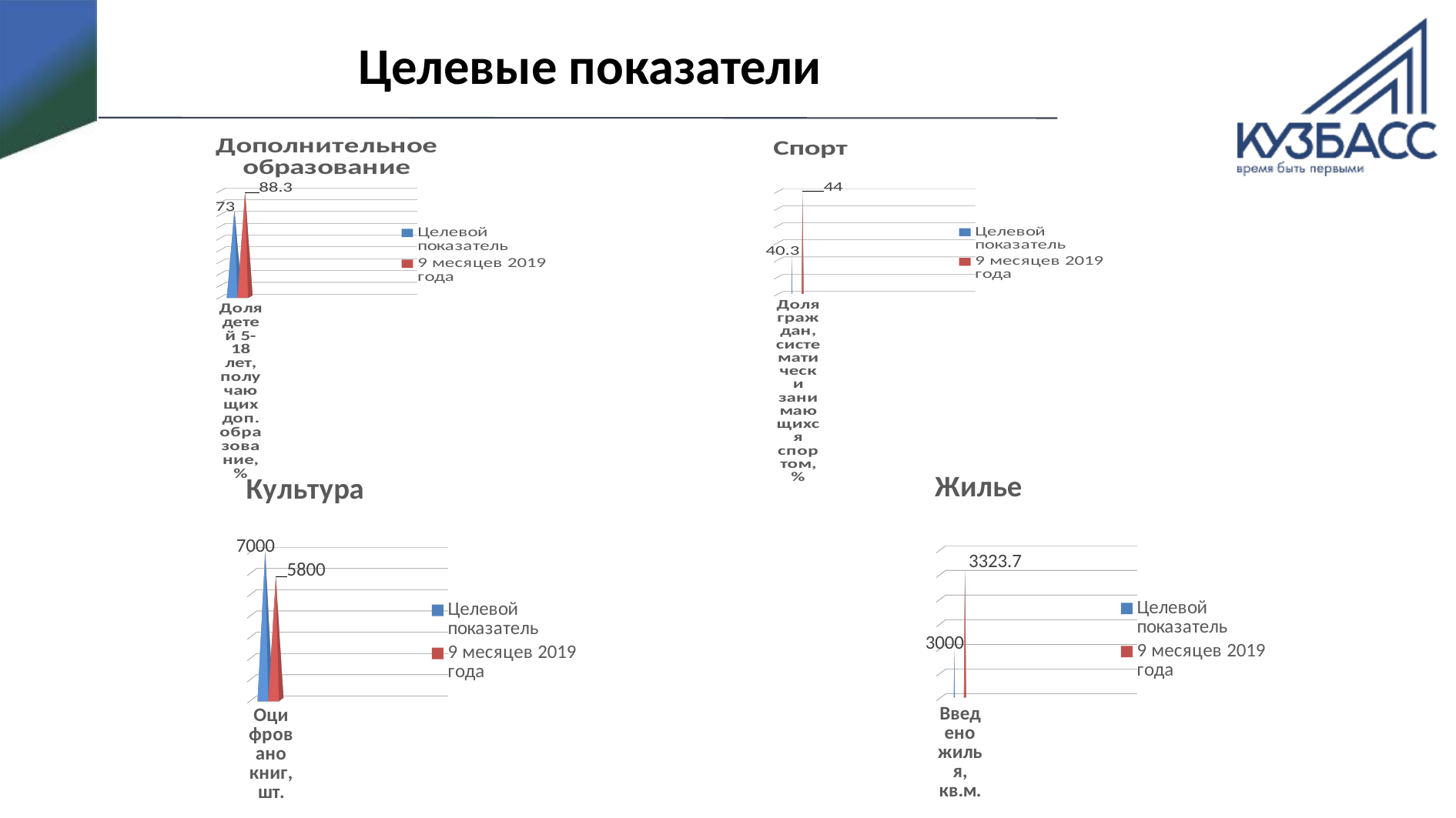
In the 'Спорт' chart, what is the value for 'Целевой показатель'? 40.3 What kind of chart is the 'Жилье' chart? Bar chart In the 'Дополнительное образование' chart, what is the value for 'Целевой показатель'? 73 In the 'Спорт' chart, what is the value for '9 месяцев 2019 года'? 44 In the 'Жилье' chart, what is the value for '9 месяцев 2019 года'? 3323.7 How many series does the legend of the 'Спорт' chart list? 2 In the 'Дополнительное образование' chart, what is the value for '9 месяцев 2019 года'? 88.3 In the 'Культура' chart, what is the value for 'Целевой показатель'? 7000 In the 'Жилье' chart, which series has the larger value: 'Целевой показатель' or '9 месяцев 2019 года'? 9 месяцев 2019 года In the 'Дополнительное образование' chart, what is the difference between '9 месяцев 2019 года' and 'Целевой показатель'? 15.3 In the 'Культура' chart, which series has the larger value: 'Целевой показатель' or '9 месяцев 2019 года'? Целевой показатель In the 'Культура' chart, what is the difference between 'Целевой показатель' and '9 месяцев 2019 года'? 1200